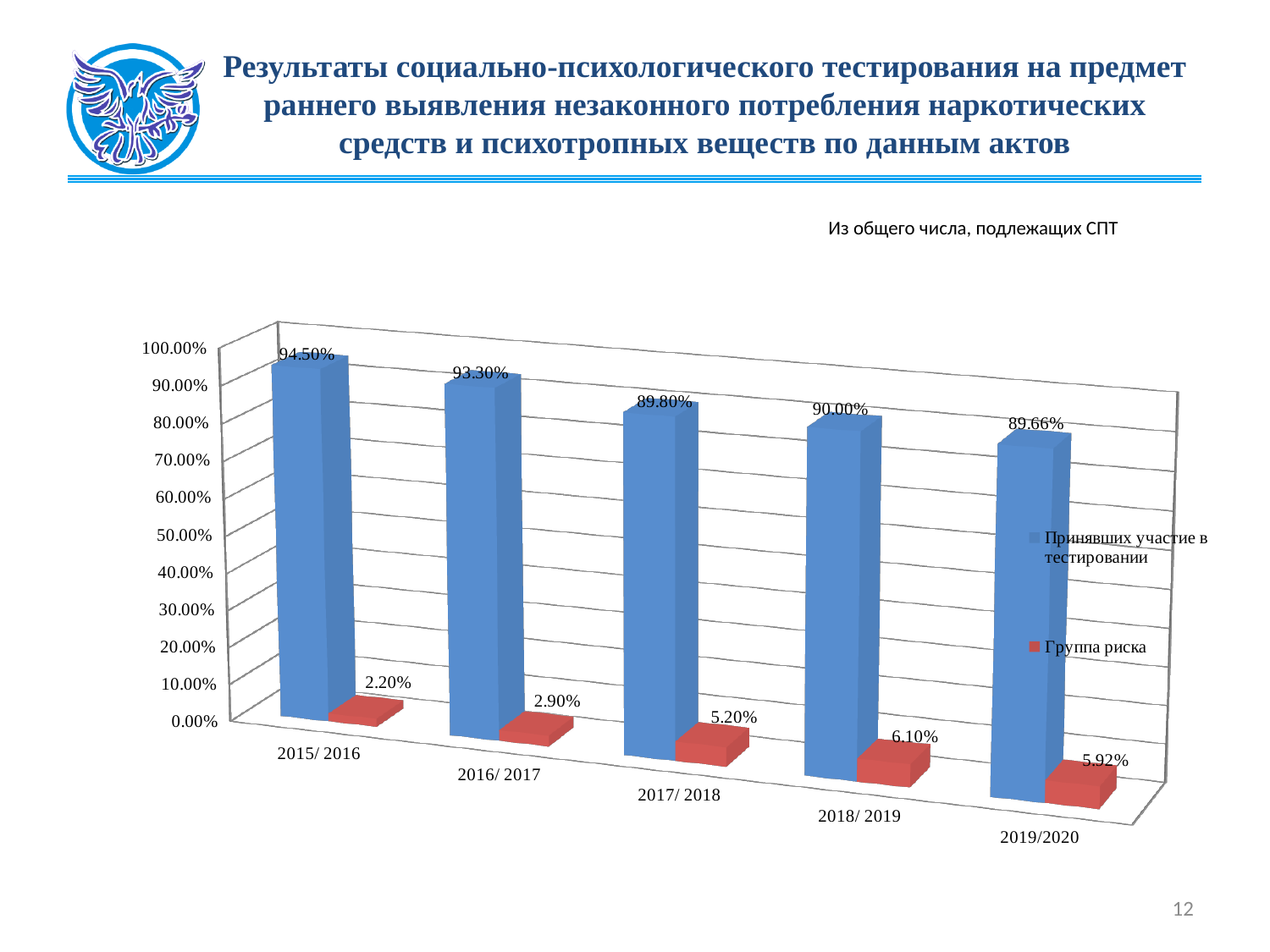
What is the value for "Принявших участие в тестировании" in 2015/2016? 94.50% Which is larger: the "Группа риска" value for 2019/2020 or for 2015/2016? 2019/2020 In which year is the "Принявших участие в тестировании" value lowest? 2019/2020 In which year is the "Группа риска" value highest? 2018/2019 What is the difference between the "Группа риска" values for 2017/2018 and 2016/2017? 2.30% Which series is shown in red in the legend? Группа риска Does the "Группа риска" value generally rise or fall from 2015/2016 to 2018/2019? rise How many academic-year categories are shown on the x axis? 5 What is the value for "Группа риска" in 2018/2019? 6.10% How many series does the chart legend list? 2 What kind of chart is shown on the slide? bar chart What is the value for "Принявших участие в тестировании" in 2019/2020? 89.66%